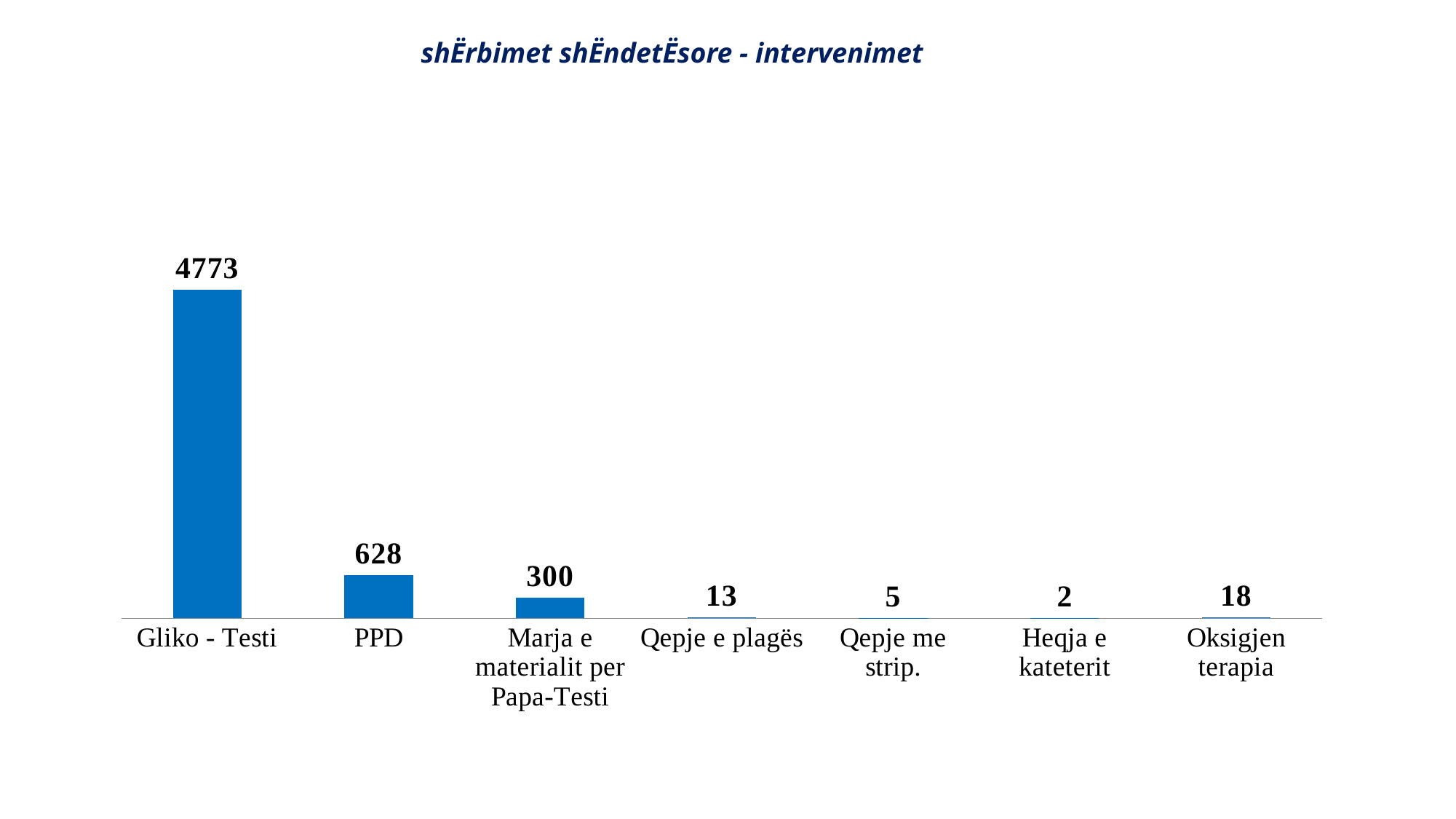
What is the value for Oksigjen terapia? 18 What is the difference between the values for Gliko - Testi and PPD? 4145 Which is larger, the value for Qepje e plagës or the value for Oksigjen terapia? Oksigjen terapia What is the value for Gliko - Testi? 4773 What kind of chart is shown on the slide? Bar chart What is the value for Heqja e kateterit? 2 How many categories are shown on the chart? 7 What is the title of the chart? shËrbimet shËndetËsore - intervenimet Which category has the highest value? Gliko - Testi What is the value for PPD? 628 What is the value for Marja e materialit per Papa-Testi? 300 Which category has the lowest value? Heqja e kateterit